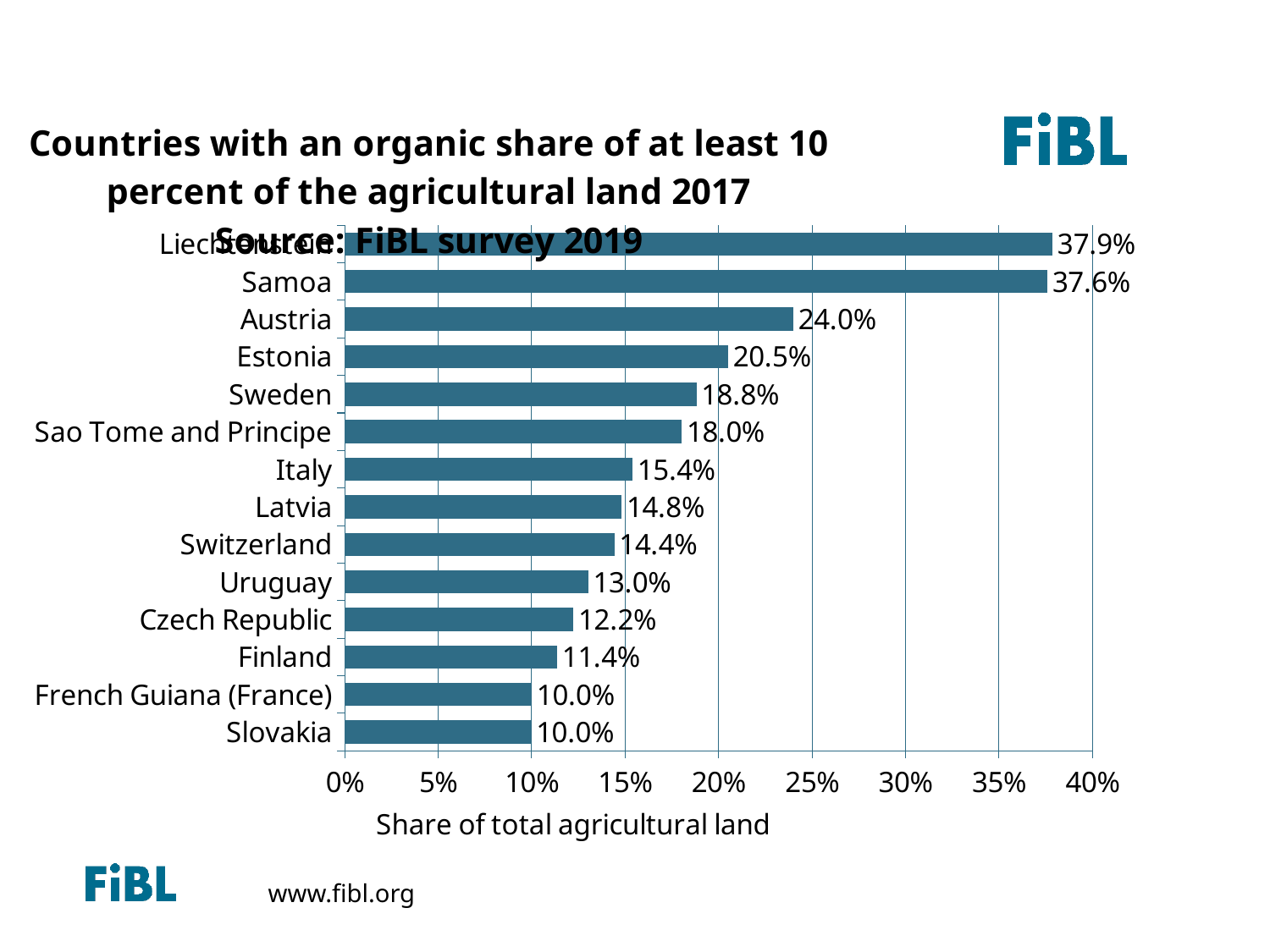
What type of chart is shown on the slide? Bar chart Which has a larger value, Uruguay or Czech Republic? Uruguay What is the organic share of agricultural land for Austria? 24.0% Which has a larger value, Italy or Latvia? Italy What is the difference between the values for Sweden and Finland? 7.4% What is the value shown for Switzerland? 14.4% Is the value for Samoa greater or less than 35%? greater What is the value shown for Sao Tome and Principe? 18.0% What is the difference between the values for Austria and Estonia? 3.5% How many countries are shown in the chart? 14 Which country has the highest organic share in the chart? Liechtenstein What is the label of the horizontal axis? Share of total agricultural land